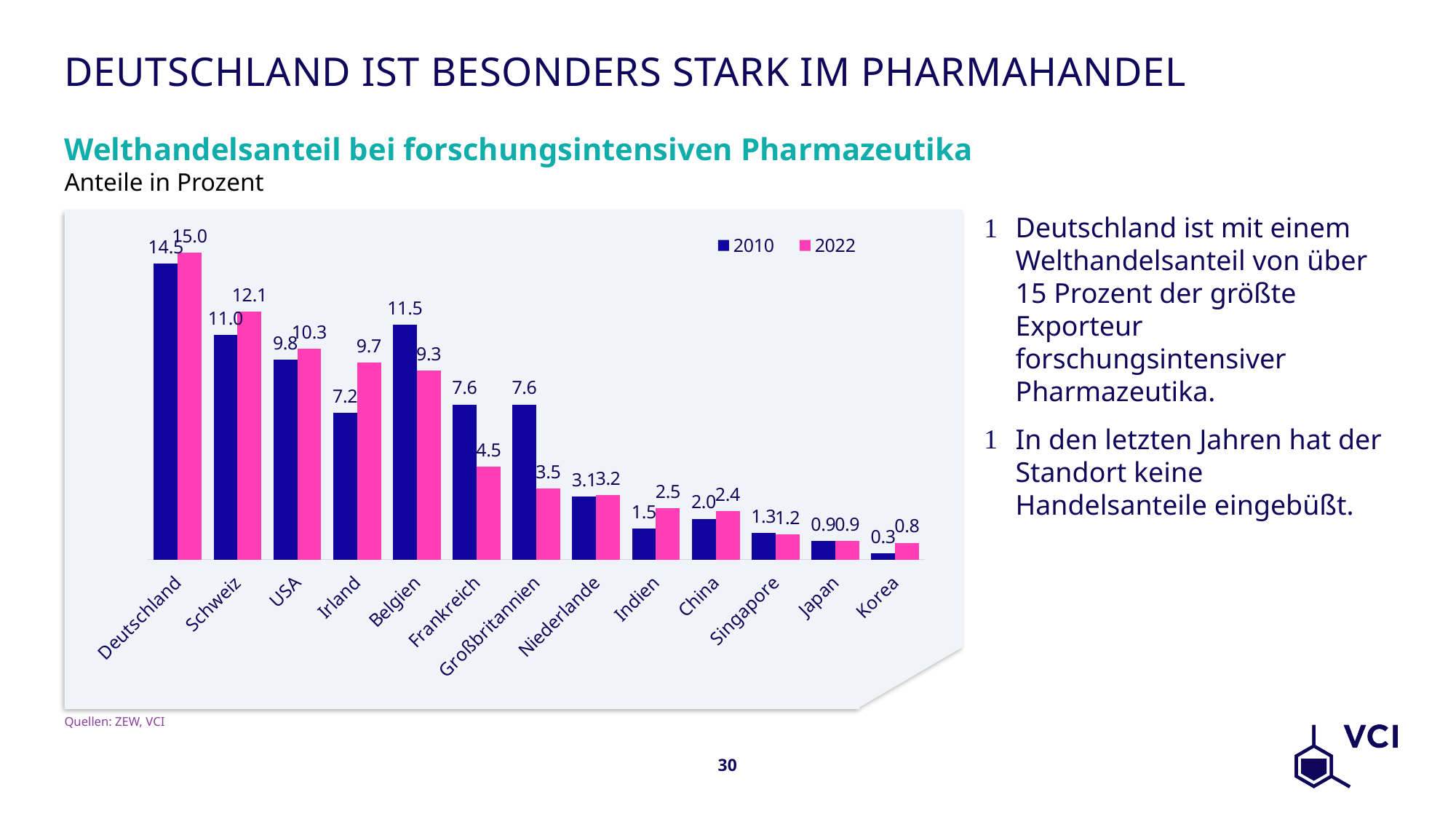
How many countries are shown on the x axis? 13 What kind of chart is shown on the slide? Bar chart Which year does the pink series represent? 2022 What is the difference between the 2010 and 2022 values for Frankreich? 3.1 Which country has the highest value in 2022? Deutschland What is the value for Großbritannien in 2022? 3.5 Which is larger for Belgien: the 2010 value or the 2022 value? 2010 What is the value for Belgien in 2010? 11.5 How many series does the legend list? 2 Which country has the lowest value in 2010? Korea What is the value for Irland in 2022? 9.7 What is the value for Deutschland in 2022? 15.0